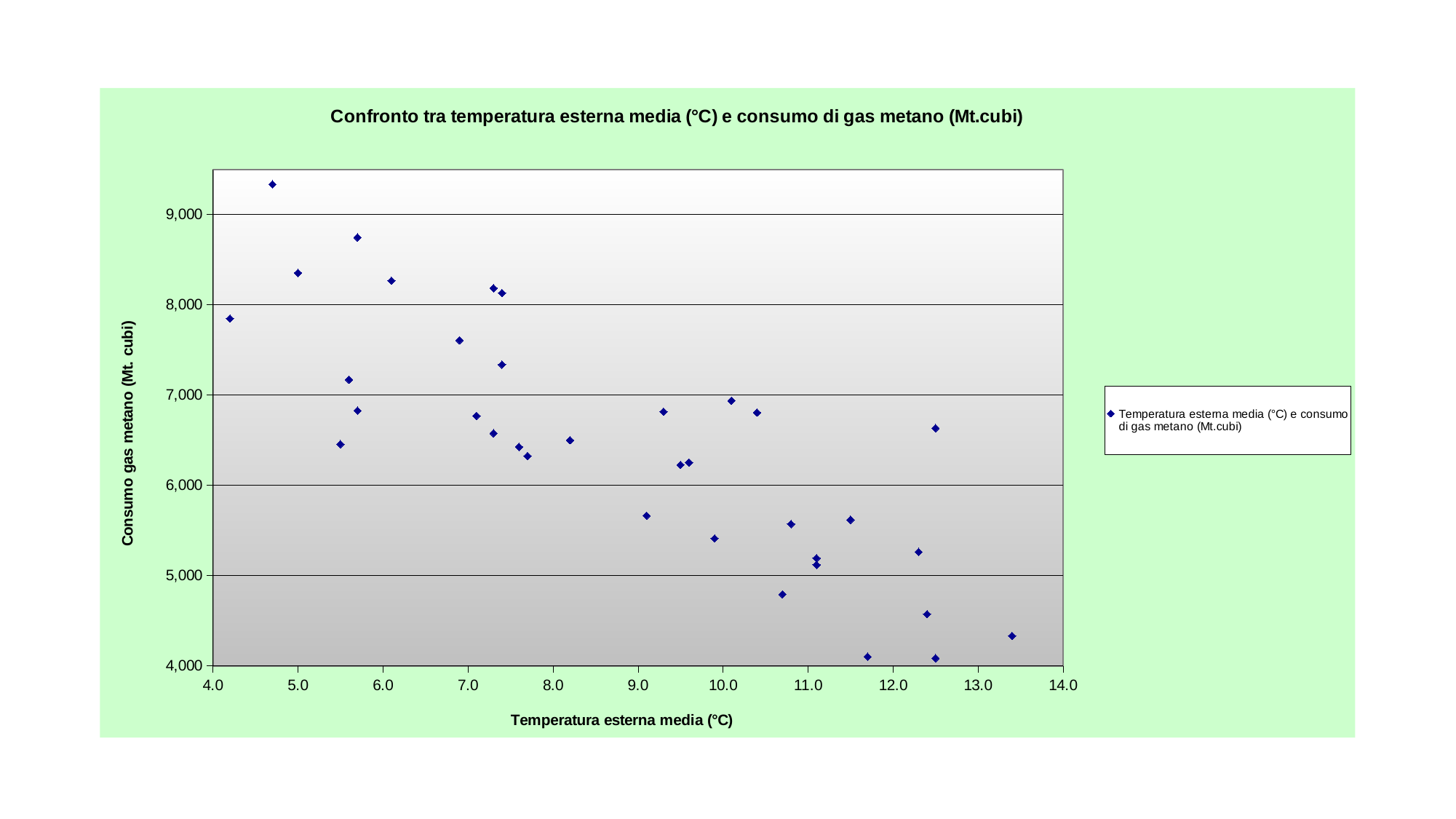
How many series does the legend list? 1 Is the gas consumption for the point with the highest temperature greater or less than 5,000? less Is the lowest gas consumption value plotted greater or less than 4,500? less What is the label of the x axis? Temperatura esterna media (°C) Is the highest gas consumption value plotted greater or less than 9,000? greater What is the highest value shown on the y axis tick labels? 9,000 What kind of chart is shown on the slide? scatter chart What is the title of the chart? Confronto tra temperatura esterna media (°C) e consumo di gas metano (Mt.cubi) As the external temperature increases along the x axis, does gas consumption generally rise or fall? fall Which has the higher gas consumption: the point with the lowest temperature or the point with the highest temperature? the point with the lowest temperature